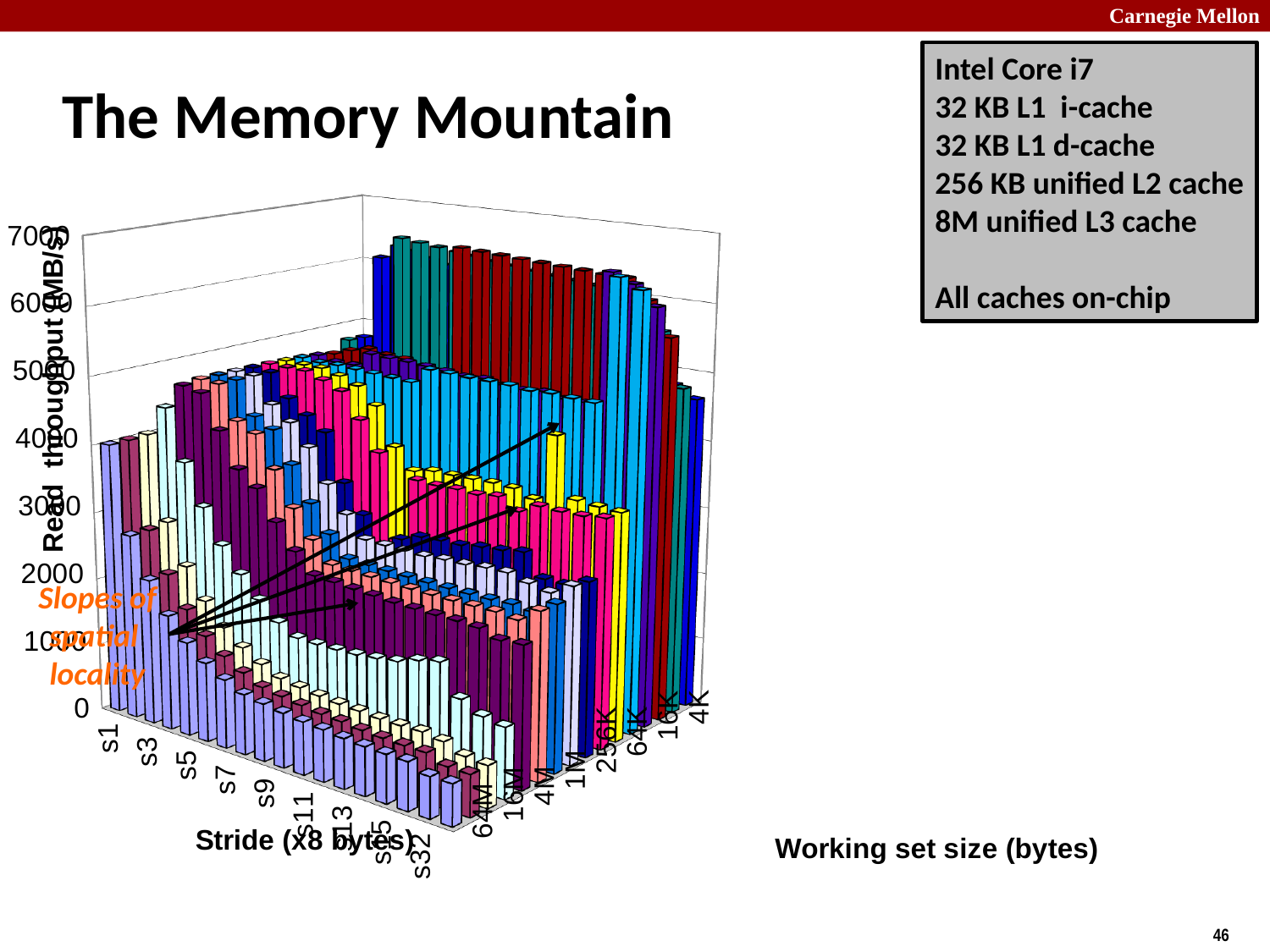
Is the tallest bar in the chart greater or less than 5000 MB/s? greater How many working set size labels are printed along the working set axis? 8 What is the title of the chart on the slide? The Memory Mountain Which working set size has taller bars at stride s1: 64M or 4K? 4K Which working set size label is at the far right end of the working set axis? 4K For the 64M working set, does read throughput rise or fall as the stride increases from s1 to s32? fall What kind of chart is shown on the slide? bar chart Which stride label is at the far end of the stride axis? s32 What quantity is plotted on the vertical axis of the chart? Read throughput (MB/s) What is the highest tick value shown on the vertical axis of the chart? 7000 What is the lowest tick value shown on the vertical axis of the chart? 0